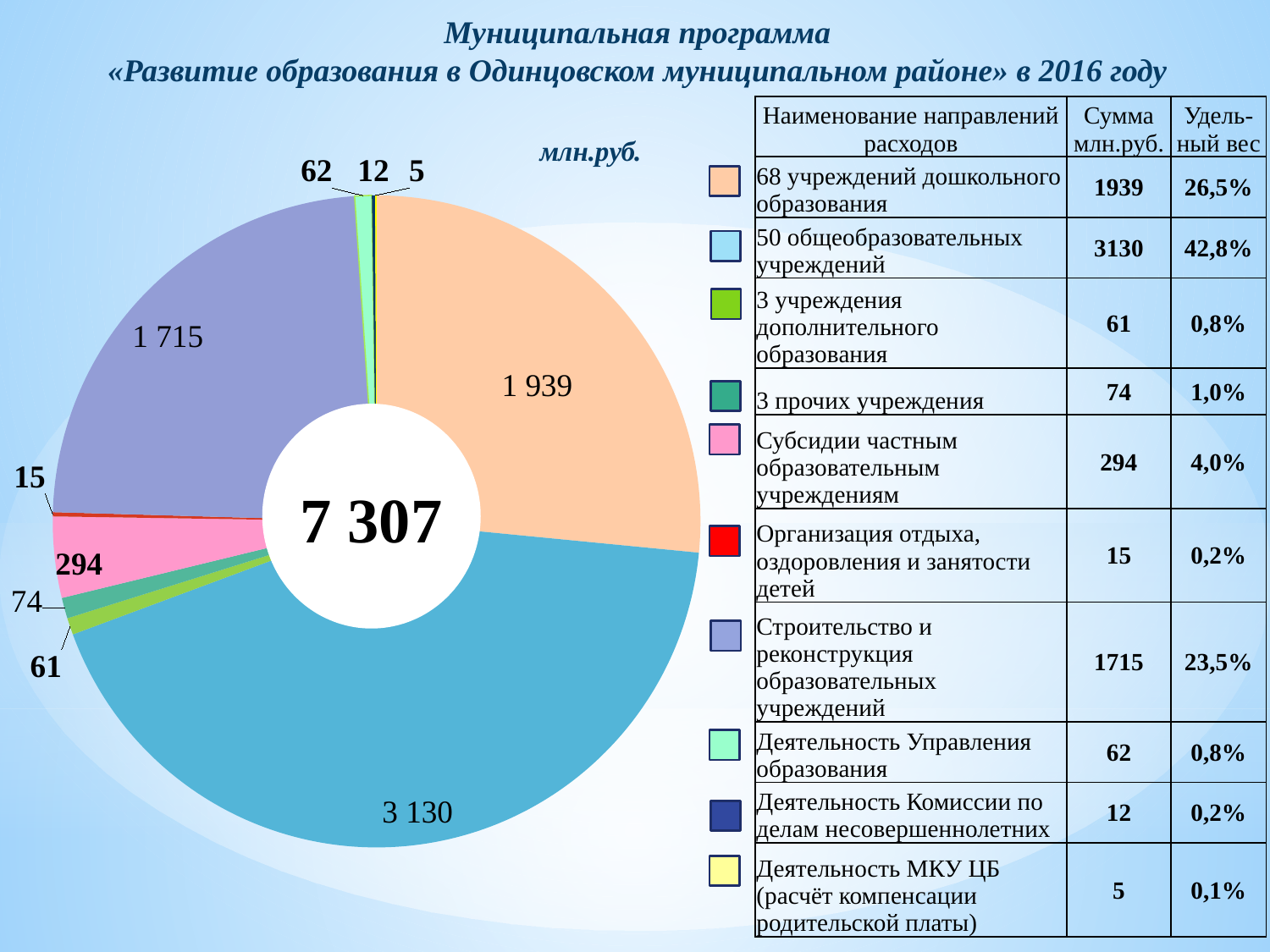
What is the value for Строительство и реконструкция образовательных учреждений? 1 715 What is the value for 50 общеобразовательных учреждений in the pie chart? 3 130 What share of the pie does 50 общеобразовательных учреждений represent? 42,8% What is the value for Субсидии частным образовательным учреждениям? 294 What total is shown in the centre of the pie chart? 7 307 How many categories does the pie chart have? 10 Which category has the smallest slice of the pie chart? Деятельность МКУ ЦБ (расчёт компенсации родительской платы) What kind of chart is shown on the slide? pie chart Which is larger: the value for 3 прочих учреждения or the value for 3 учреждения дополнительного образования? 3 прочих учреждения Which category has the largest slice of the pie chart? 50 общеобразовательных учреждений What is the difference between the values for 50 общеобразовательных учреждений and 68 учреждений дошкольного образования? 1 191 What is the value for 68 учреждений дошкольного образования in the pie chart? 1 939